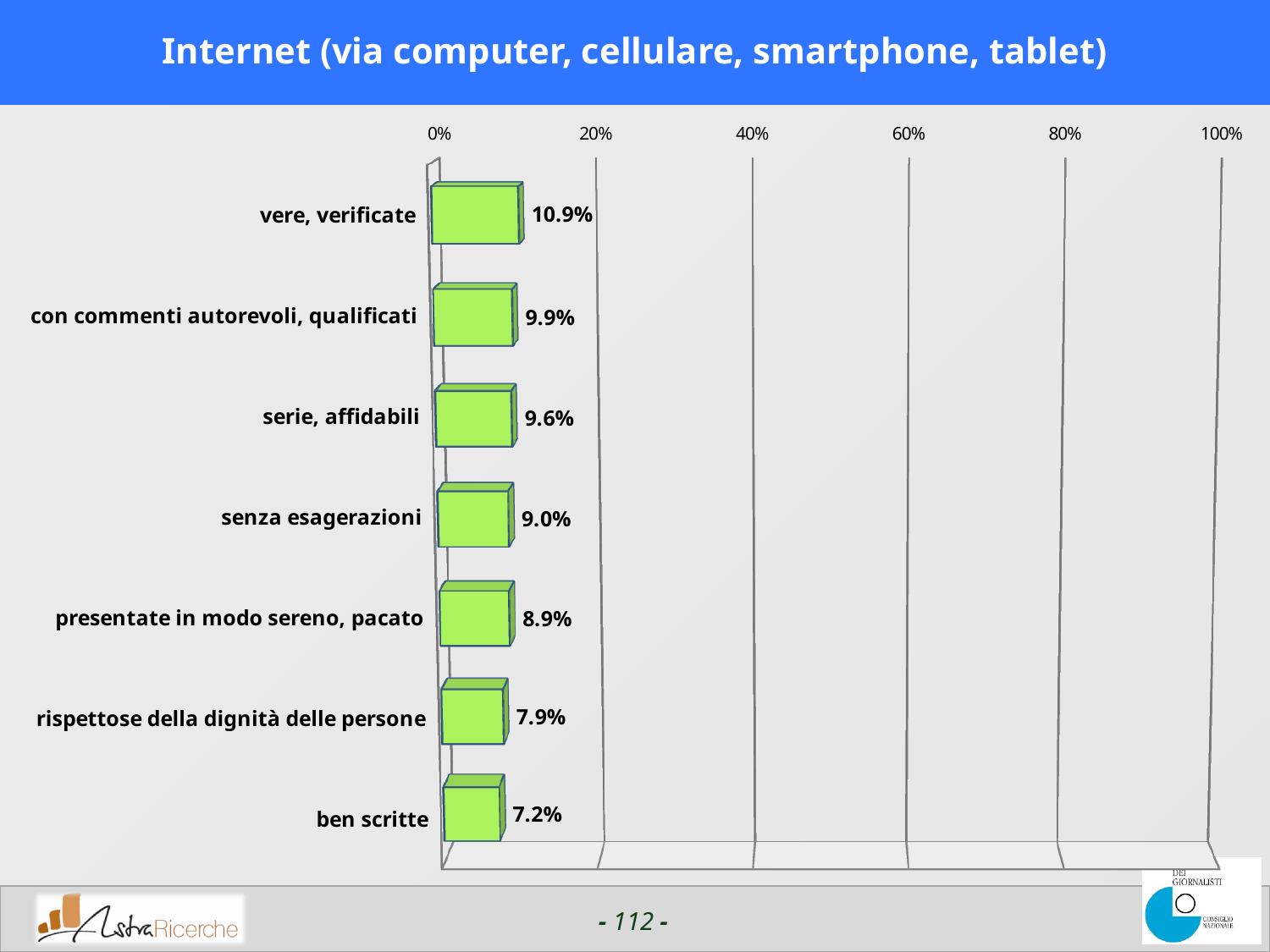
What is the value for "ben scritte"? 7.2% How many categories are shown in the chart? 7 What is the difference between the values for "vere, verificate" and "ben scritte"? 3.7% What is the highest value shown on the horizontal axis? 100% What is the value for "vere, verificate"? 10.9% What is the value for "senza esagerazioni"? 9.0% Is the value for "con commenti autorevoli, qualificati" greater or less than 20%? less Which category has the lowest value? ben scritte What kind of chart is shown on the slide? bar chart What is the title of the chart? Internet (via computer, cellulare, smartphone, tablet) Which is larger: the value for "serie, affidabili" or the value for "rispettose della dignità delle persone"? serie, affidabili Which category has the highest value? vere, verificate